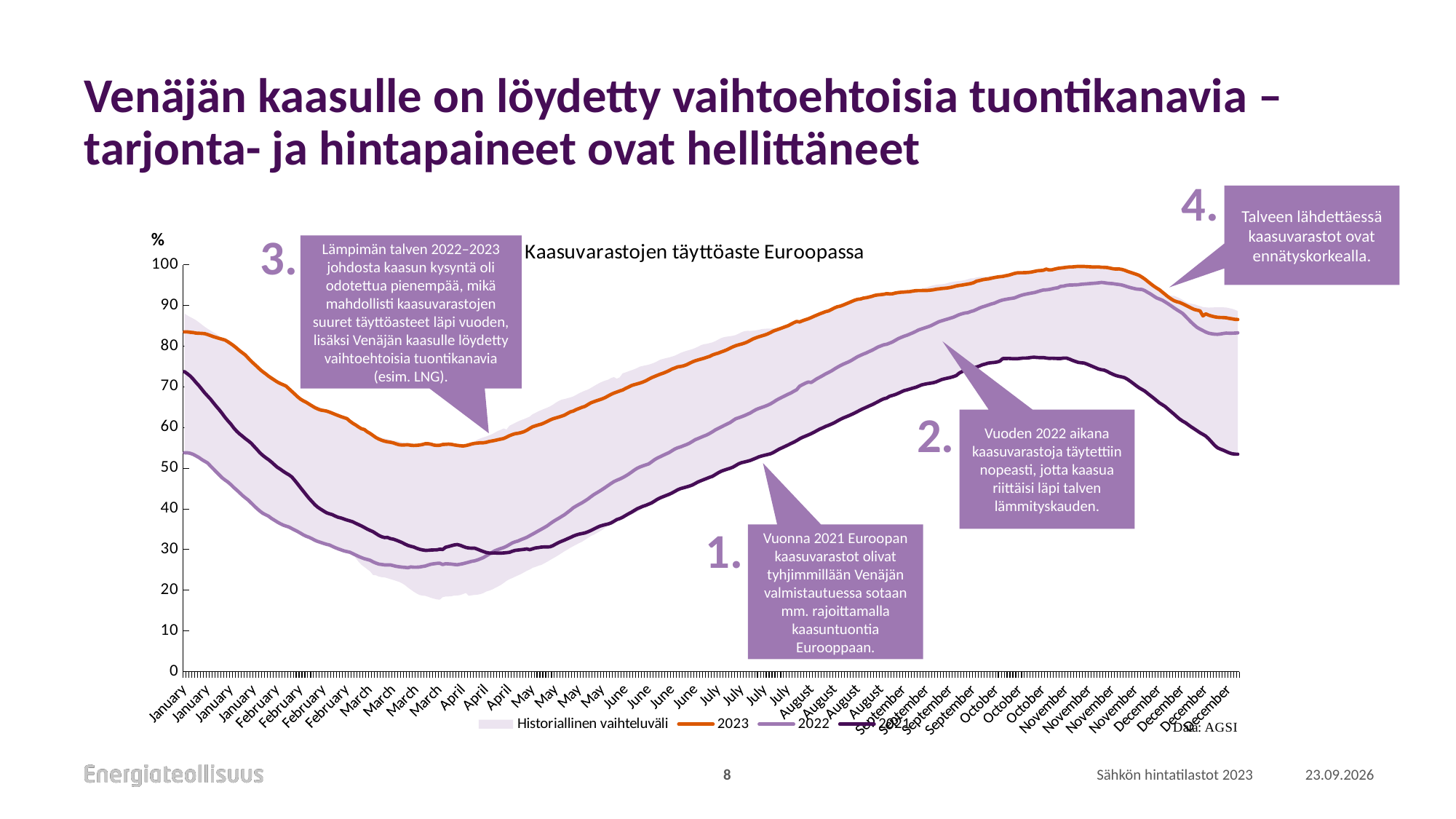
Which series has the highest value at the end of December: 2023, 2022 or 2021? 2023 Is the value of the 2021 line at the start of January greater or less than 70? greater What is the title of the chart? Kaasuvarastojen täyttöaste Euroopassa Is the lowest point of the 2023 line (around March–April) greater or less than 50? greater Is the peak of the 2022 line (around November) greater or less than 90? greater What kind of chart is shown on the slide? line chart Does the 2022 line rise or fall from April to November? rise What unit is shown on the y axis of the chart? % How many entries does the legend of the chart list? 4 Which series has the lowest value at the start of January: 2023, 2022 or 2021? 2022